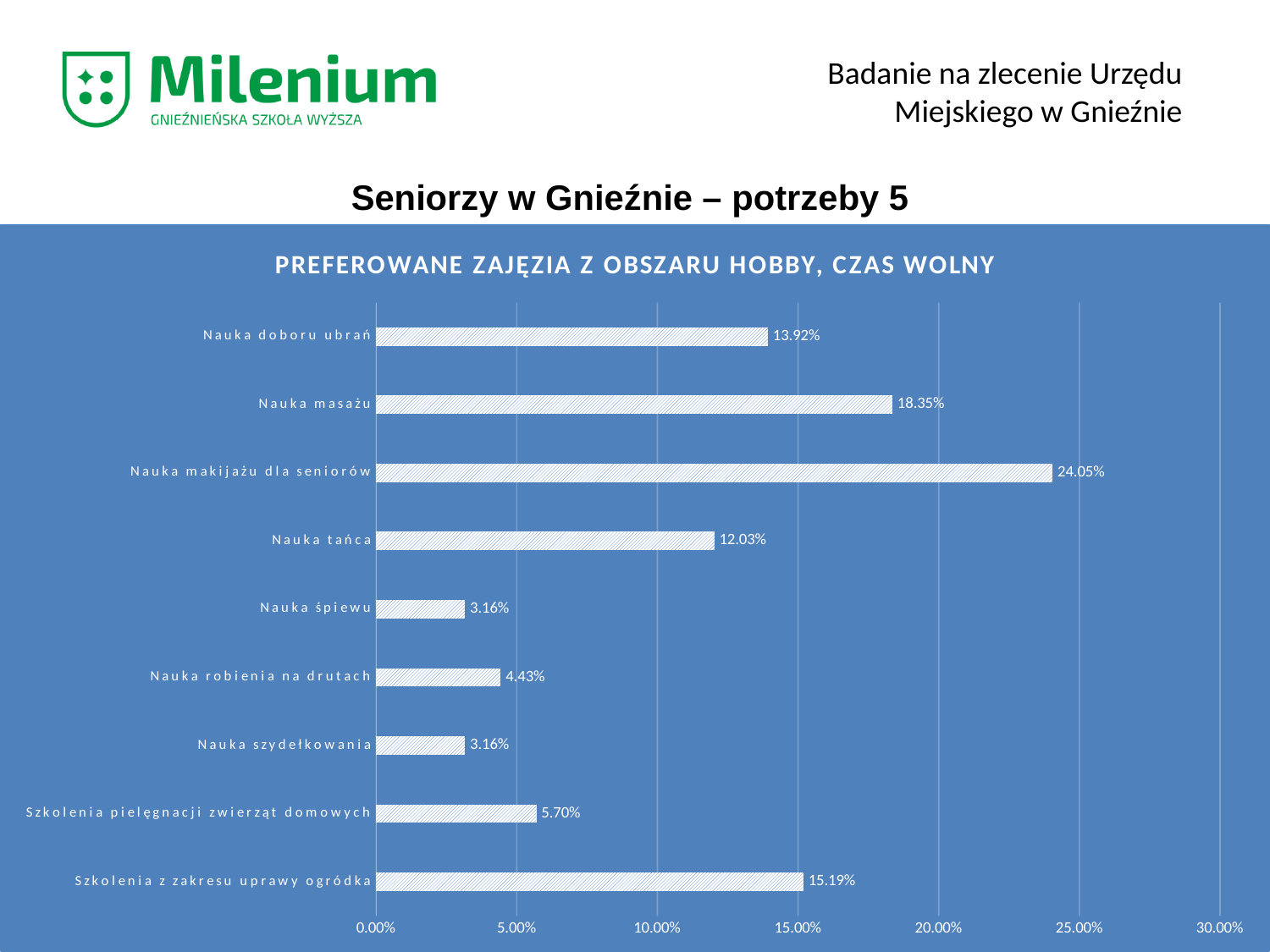
What is the value for Nauka masażu? 18.35% Is the value for Nauka tańca greater or less than 10.00%? greater Which category has the highest value? Nauka makijażu dla seniorów What kind of chart is shown on the slide? bar chart What is the title of the chart? PREFEROWANE ZAJĘZIA Z OBSZARU HOBBY, CZAS WOLNY What is the value for Szkolenia z zakresu uprawy ogródka? 15.19% What is the value for Szkolenia pielęgnacji zwierząt domowych? 5.70% Which is larger, Szkolenia z zakresu uprawy ogródka or Nauka doboru ubrań? Szkolenia z zakresu uprawy ogródka What is the difference between Nauka doboru ubrań and Nauka tańca? 1.89% What is the difference between Nauka makijażu dla seniorów and Nauka masażu? 5.70% What is the value for Nauka makijażu dla seniorów? 24.05% How many categories are shown in the chart? 9